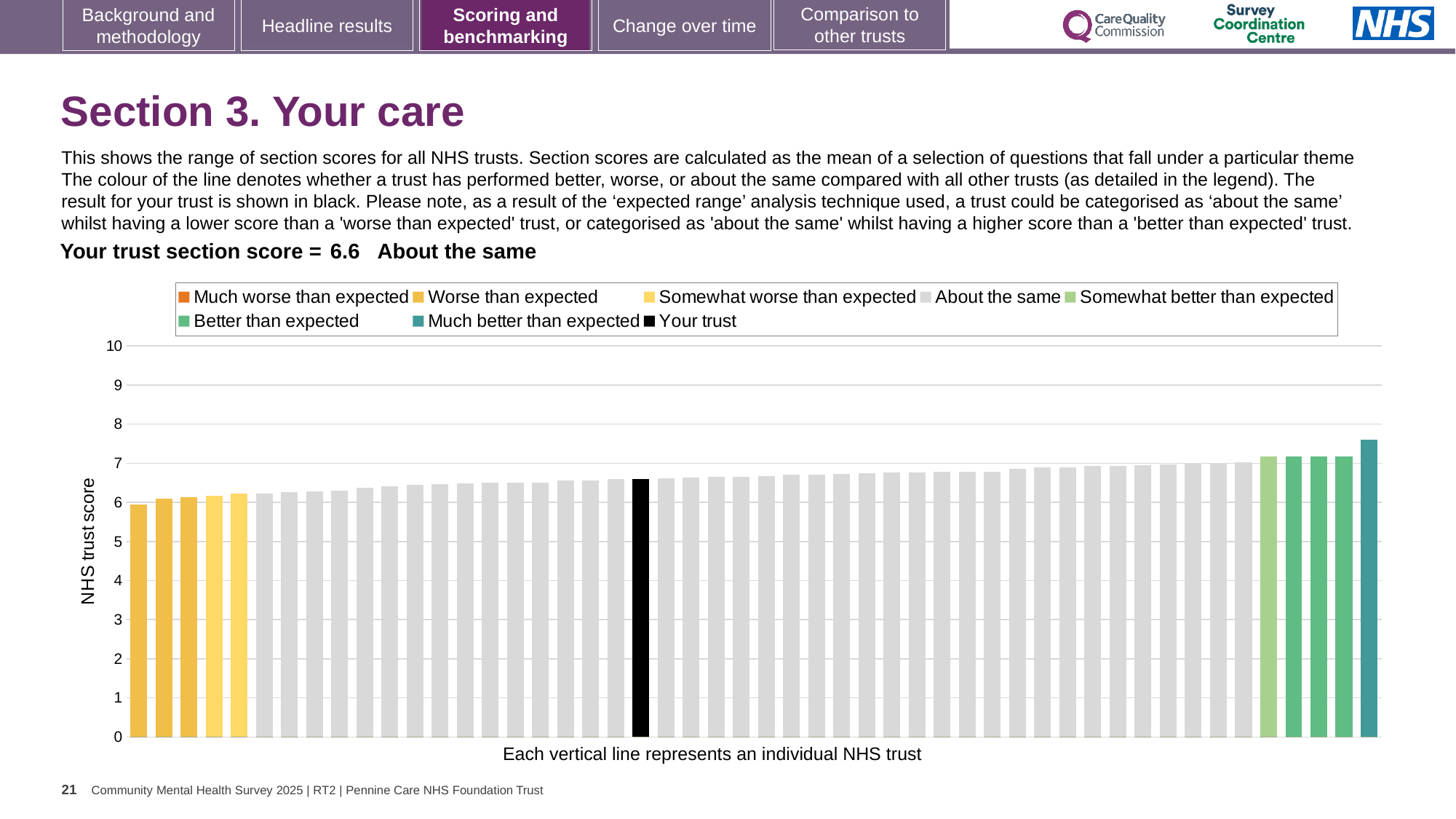
Do the bar values rise or fall from left to right along the x axis? Rise Is the value for your trust greater or less than 7? less Is the value of the lowest bar greater or less than 5? greater Is the value for your trust greater or less than 6? greater What is the section score for your trust shown on the slide? 6.6 How many entries does the chart legend list? 8 Which performance category is your trust's section score placed in? About the same What is the label on the vertical axis of the chart? NHS trust score What kind of chart is shown on the slide? Bar chart Which legend category does the highest bar on the chart belong to? Much better than expected